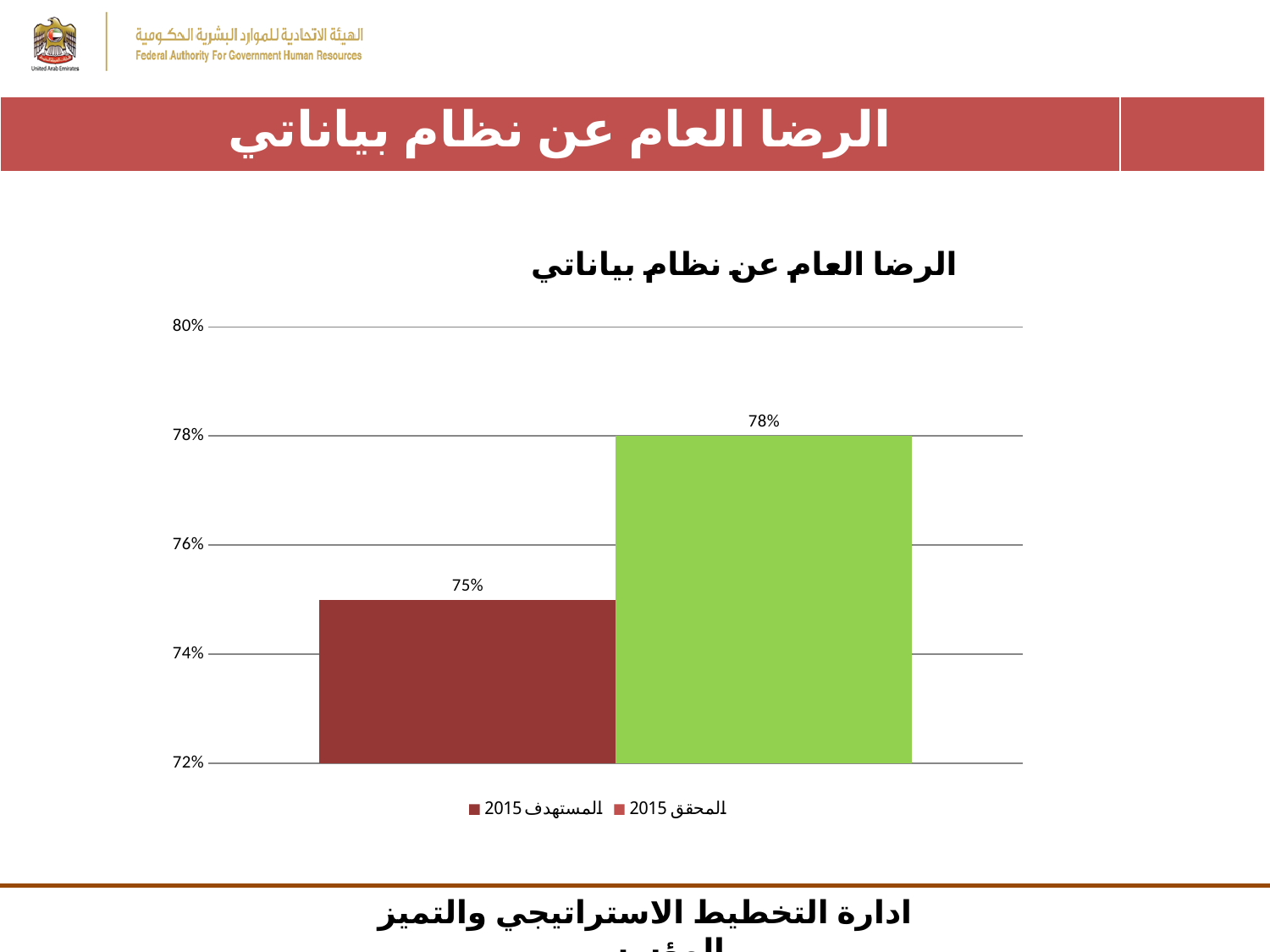
What is the difference between the value for المحقق 2015 and the value for المستهدف 2015? 3% How many series does the legend list? 2 What type of chart is shown on the slide? bar chart Which series has the higher value, المستهدف 2015 or المحقق 2015? المحقق 2015 Is the value for المستهدف 2015 greater or less than 76%? less How many bars are plotted in the chart? 2 What colour is the bar for المحقق 2015? green What is the title of the chart? الرضا العام عن نظام بياناتي What is the value for المستهدف 2015? 75% What is the value for المحقق 2015? 78% Which series has the lowest value? المستهدف 2015 Is the value for المحقق 2015 greater or less than 76%? greater